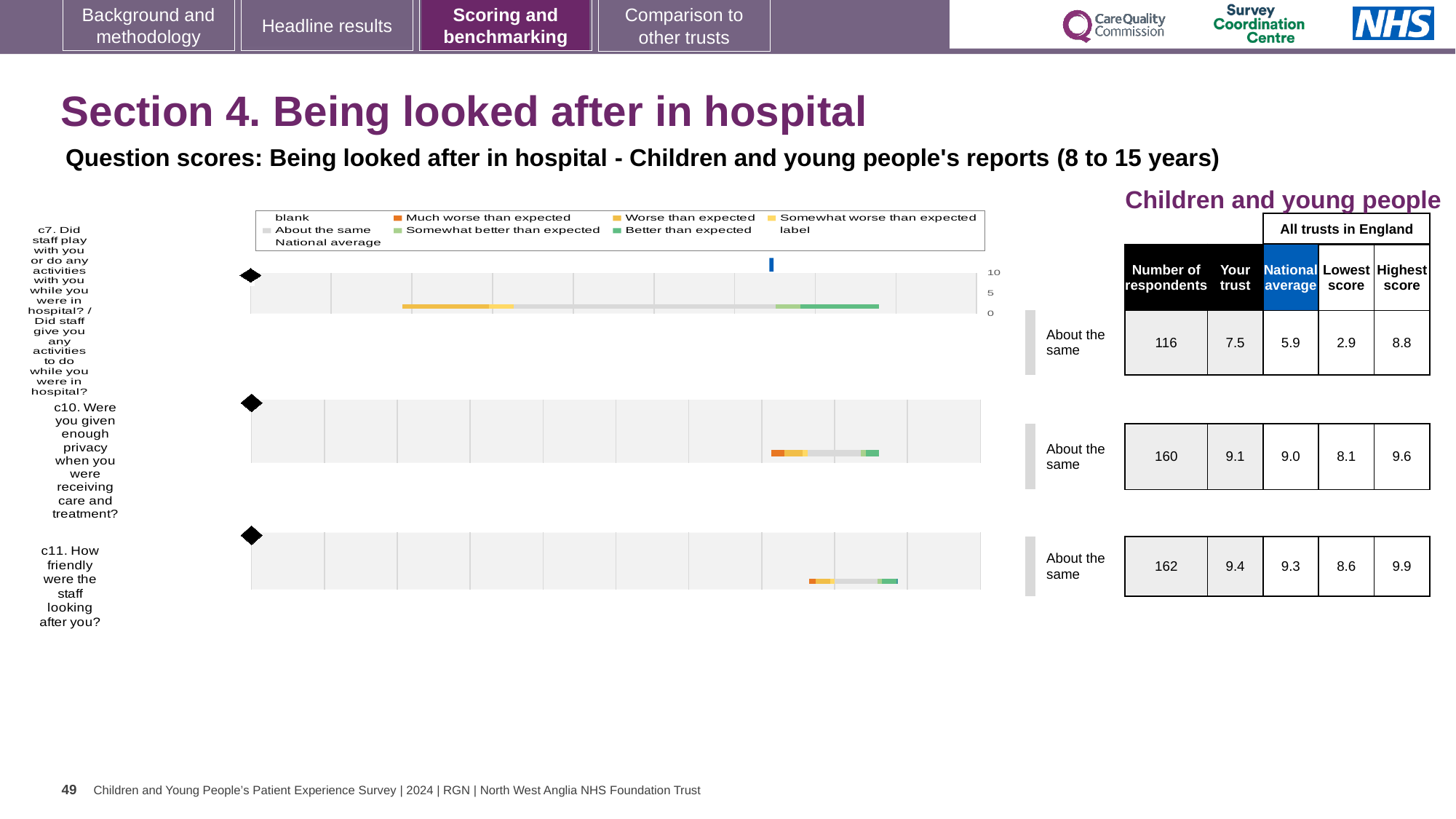
What is the highest score across all trusts in England for question c11 (How friendly were the staff looking after you?)? 9.9 What is the national average score for question c10 (Were you given enough privacy when you were receiving care and treatment?)? 9.0 What is the difference between the highest score (8.8) and the lowest score (2.9) for question c7? 5.9 What is the 'Your trust' score for question c7 (Did staff play with you or do any activities with you while you were in hospital?)? 7.5 What kind of chart is used to show the question scores on this slide? bar chart What is the lowest score across all trusts in England for question c10? 8.1 Which question has the lowest number of respondents? c7. Did staff play with you or do any activities with you while you were in hospital? For question c11, is the 'Your trust' score higher or lower than the national average? higher Which question has the highest 'Your trust' score? c11. How friendly were the staff looking after you? What benchmark category is shown for question c10? About the same How many respondents answered question c10? 160 How many questions (categories) are plotted on the slide? 3